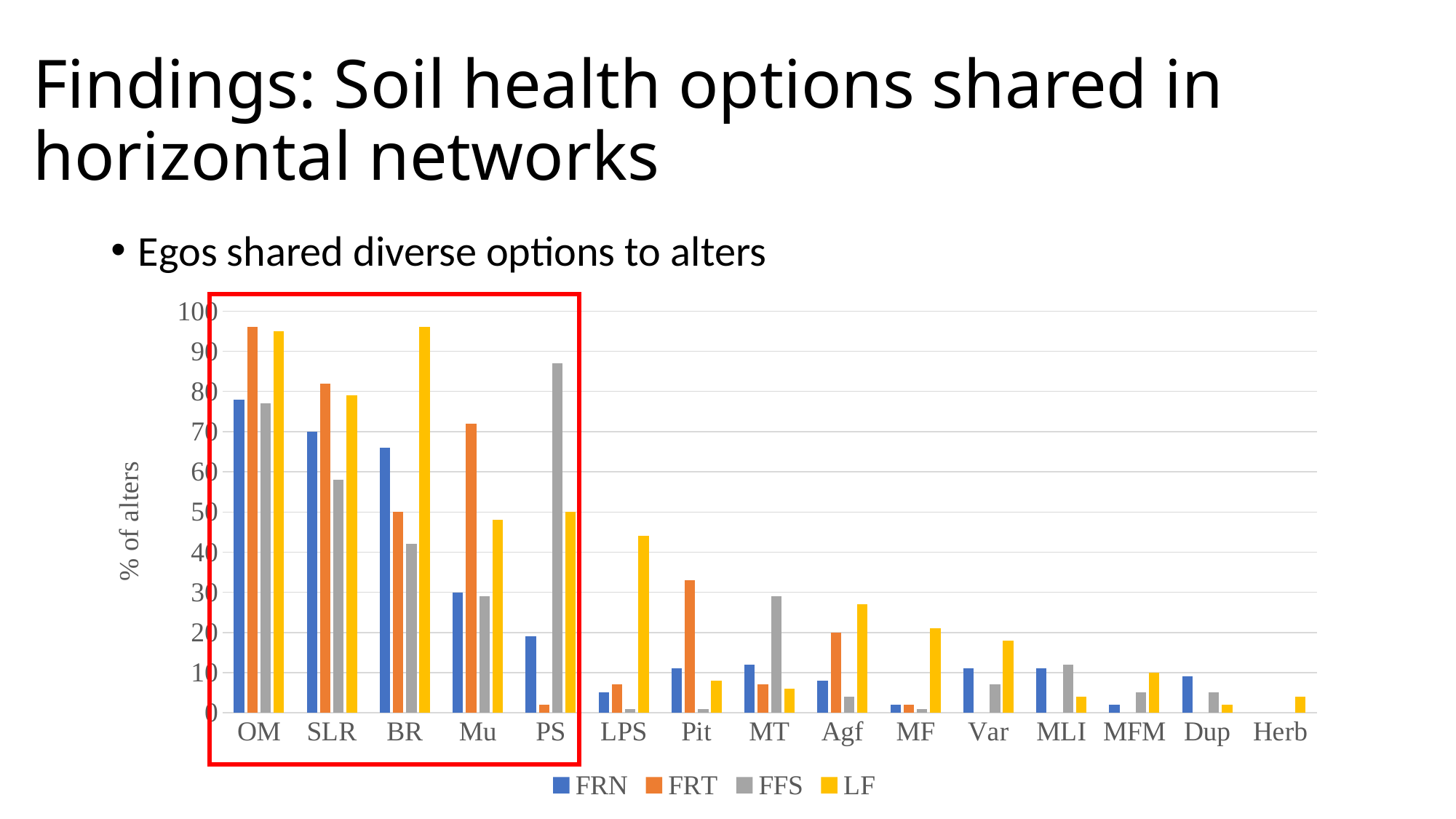
Which category has the highest FRN value? OM For PS, which is larger, the FFS value or the LF value? FFS Is the FRT value for OM greater or less than 90? greater Is the FRN value for BR greater or less than 60? greater What kind of chart is shown on the slide? bar chart Is the LF value for LPS greater or less than 40? greater How many series does the legend list? 4 For OM, which is larger, the FRN value or the FRT value? FRT Which categories are enclosed by the red box? OM, SLR, BR, Mu, PS What is the label of the vertical axis? % of alters How many categories are shown on the x axis? 15